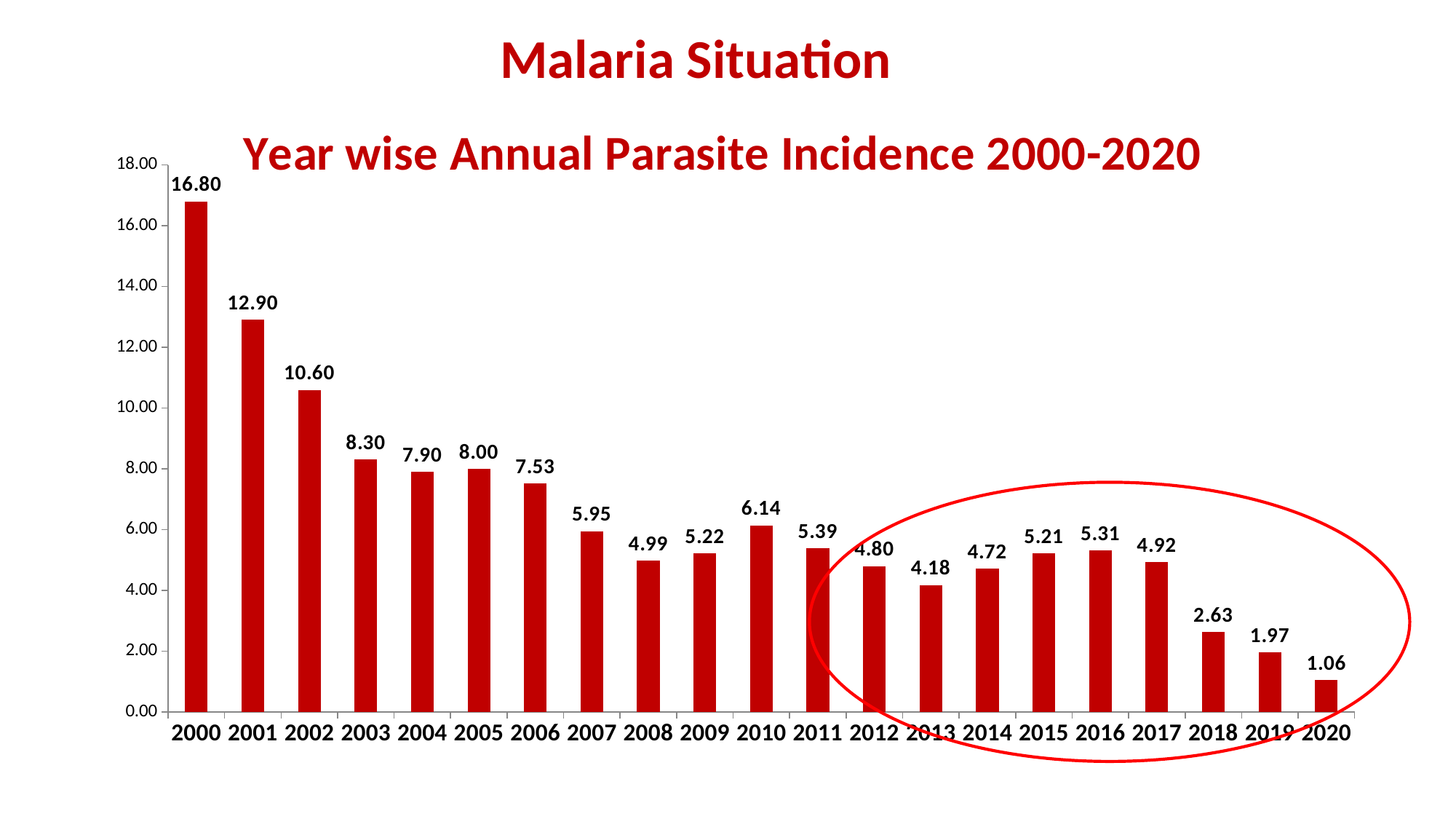
What is the difference between the values for 2018 and 2019? 0.66 Which year has the highest Annual Parasite Incidence? 2000 Which year has the lowest Annual Parasite Incidence? 2020 How many years are shown on the x axis? 21 What kind of chart is shown on the slide? Bar chart What is the Annual Parasite Incidence value for 2000? 16.80 Is the value for 2003 greater or less than 8.00? greater What is the Annual Parasite Incidence value for 2010? 6.14 What is the Annual Parasite Incidence value for 2020? 1.06 What is the difference between the values for 2000 and 2001? 3.90 Which year has a larger value, 2015 or 2016? 2016 What is the title of the chart? Year wise Annual Parasite Incidence 2000-2020